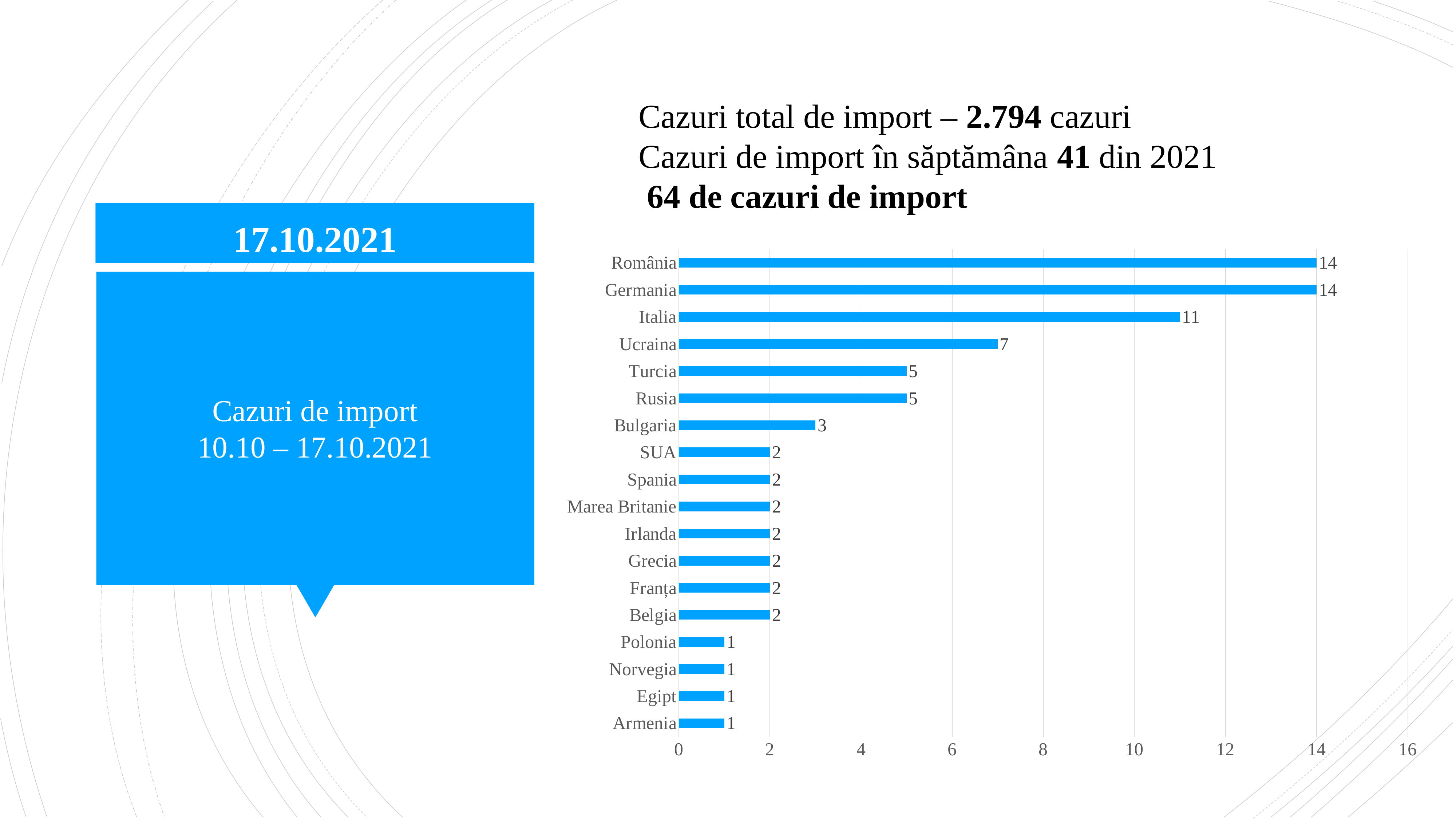
How many categories are shown in the chart? 18 What kind of chart is shown on the slide? bar chart What is the value for Ucraina? 7 What is the difference between the values for România and Turcia? 9 Which is larger, the value for Bulgaria or the value for SUA? Bulgaria What is the maximum value shown on the x axis? 16 What is the value for Polonia? 1 What is the difference between the values for Italia and Ucraina? 4 Which is larger, the value for Ucraina or the value for Rusia? Ucraina What is the value for Italia? 11 What is the value for Bulgaria? 3 What is the highest value shown in the chart? 14